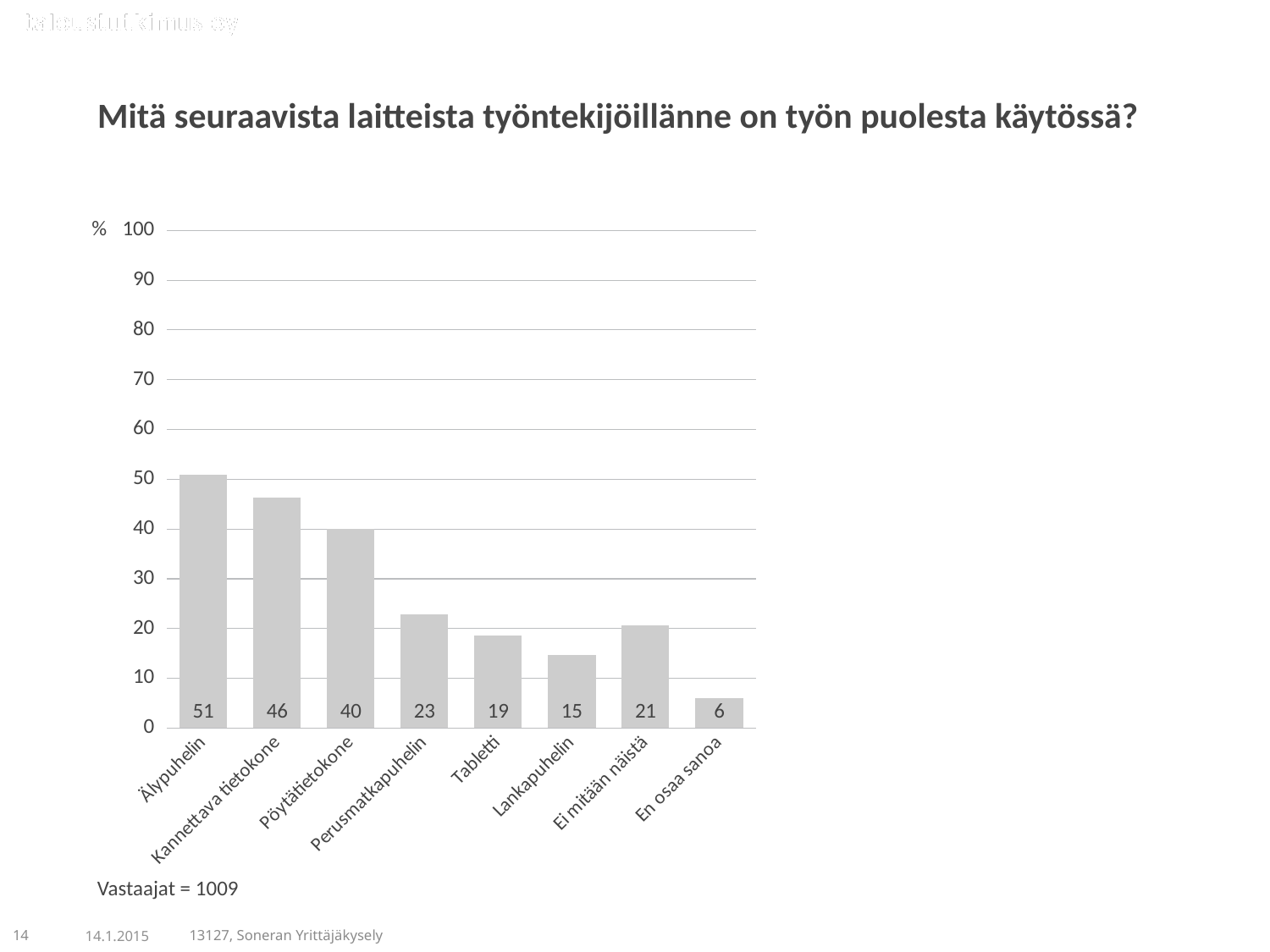
What is the value for Ei mitään näistä? 21 What is the difference between the values for Kannettava tietokone and Pöytätietokone? 6 Which category has the highest value? Älypuhelin What is the title of the chart? Mitä seuraavista laitteista työntekijöillänne on työn puolesta käytössä? How many categories are shown on the x axis? 8 What is the number of respondents (Vastaajat) stated below the chart? 1009 What is the value for Tabletti? 19 What kind of chart is shown on the slide? bar chart Which category has the lowest value? En osaa sanoa Is the value for Pöytätietokone greater or less than 30? greater Which is larger, the value for Perusmatkapuhelin or the value for Lankapuhelin? Perusmatkapuhelin What is the value for Älypuhelin? 51